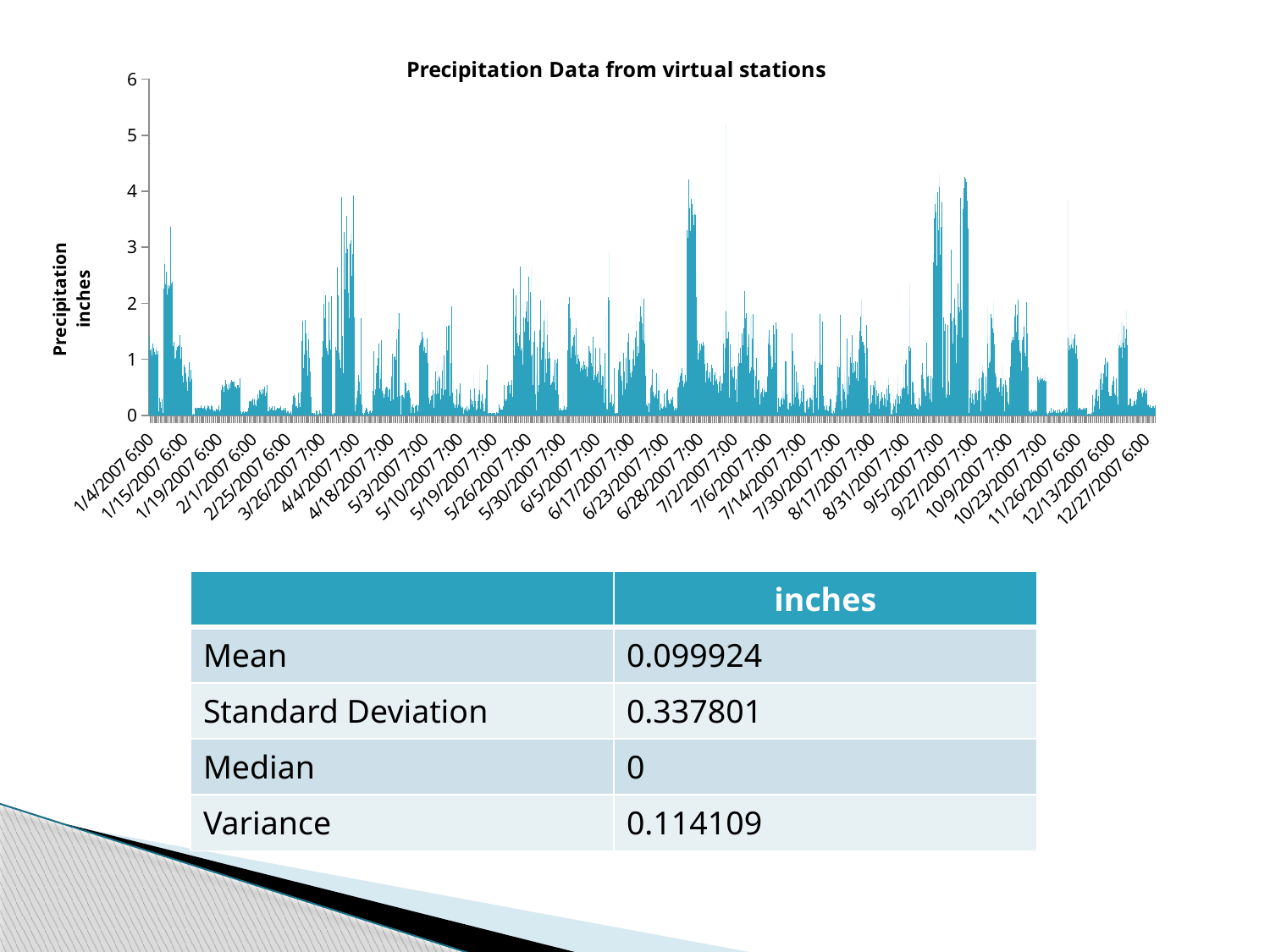
What is the highest tick value shown on the vertical axis? 6 Is the highest precipitation value plotted on the chart greater or less than 4? greater What is the first date label on the horizontal axis? 1/4/2007 6:00 What is the last date label on the horizontal axis? 12/27/2007 6:00 Is the highest precipitation value plotted on the chart greater or less than 6? less Is the peak precipitation value near 1/15/2007 6:00 greater or less than 4? less What is the label on the vertical axis of the chart? Precipitation inches What is the lowest tick value shown on the vertical axis? 0 What is the title of the chart? Precipitation Data from virtual stations Which year do the dates on the horizontal axis cover? 2007 What kind of chart is shown on the slide? bar chart